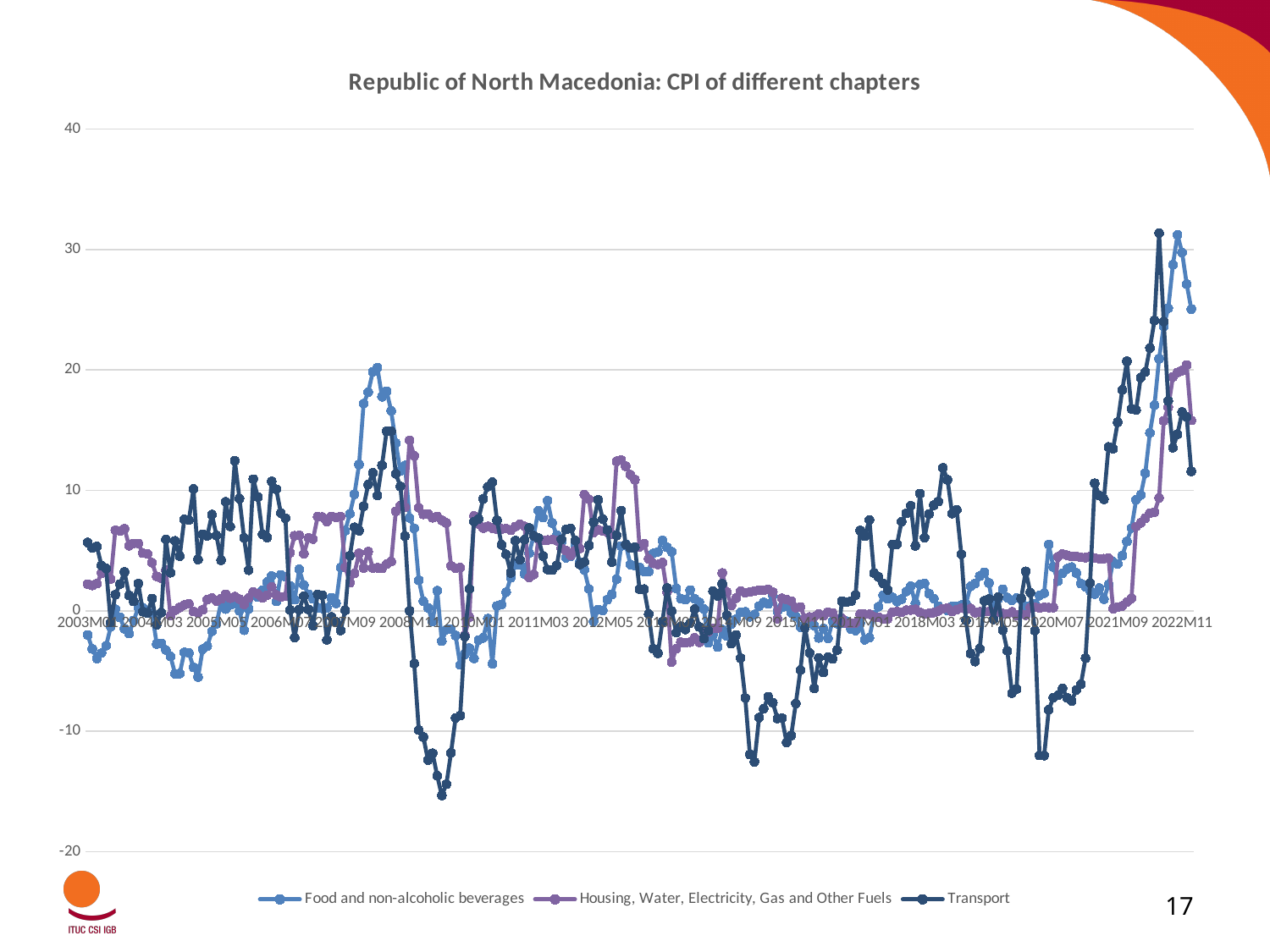
Which series is shown in purple in the legend? Housing, Water, Electricity, Gas and Other Fuels How many series does the legend list? 3 Is the lowest value of the Transport series (around 2009) greater or less than -10? less Is the peak of the Food and non-alcoholic beverages series in 2022 greater or less than 20? greater Is the peak of the Food and non-alcoholic beverages series around 2008 greater or less than 10? greater What kind of chart is shown on the slide? line chart Which series has the highest value at the last point on the chart (2022M11)? Food and non-alcoholic beverages What is the title of the chart? Republic of North Macedonia: CPI of different chapters Around 2009, which is lower: the Transport series or the Food and non-alcoholic beverages series? Transport Does the Food and non-alcoholic beverages series rise or fall between 2021M09 and its 2022 peak? rise Which series reaches the lowest value anywhere on the chart? Transport